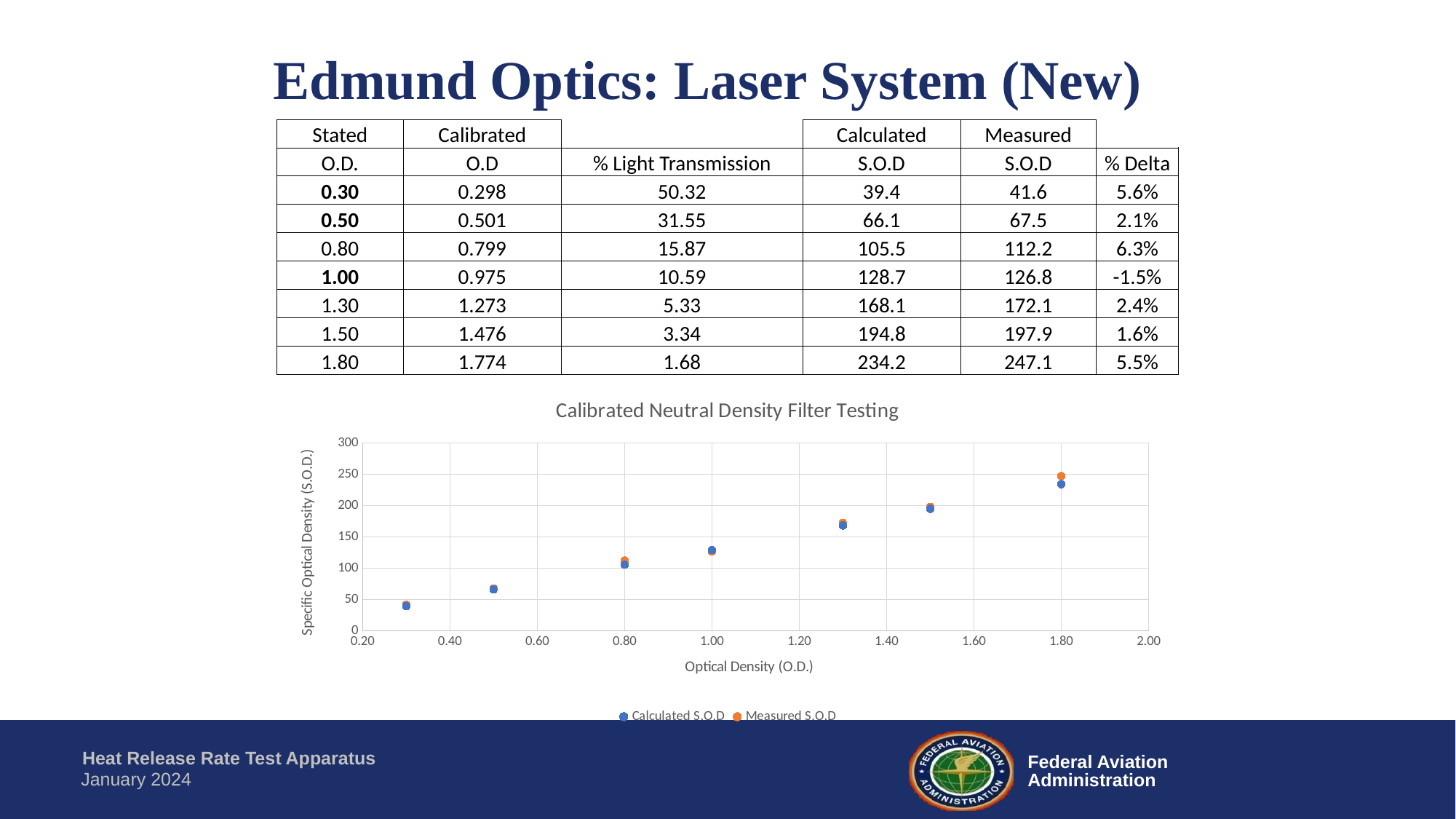
Do the Measured S.O.D values rise or fall as Optical Density increases along the x axis? Rise What is the label of the x axis of the chart? Optical Density (O.D.) Is the Measured S.O.D value at an Optical Density of 1.80 greater or less than 200? greater At which Optical Density is the Measured S.O.D value highest? 1.80 What is the title of the chart on the slide? Calibrated Neutral Density Filter Testing What kind of chart is shown under the title 'Calibrated Neutral Density Filter Testing'? Scatter chart At which Optical Density is the Calculated S.O.D value lowest? 0.30 Is the Calculated S.O.D value at an Optical Density of 0.30 greater or less than 50? less At an Optical Density of 1.80, which series has the higher value, Calculated S.O.D or Measured S.O.D? Measured S.O.D How many series does the legend of the 'Calibrated Neutral Density Filter Testing' chart list? 2 Is the Calculated S.O.D value at an Optical Density of 1.00 greater or less than 100? greater How many data points does the Calculated S.O.D series have in the chart? 7